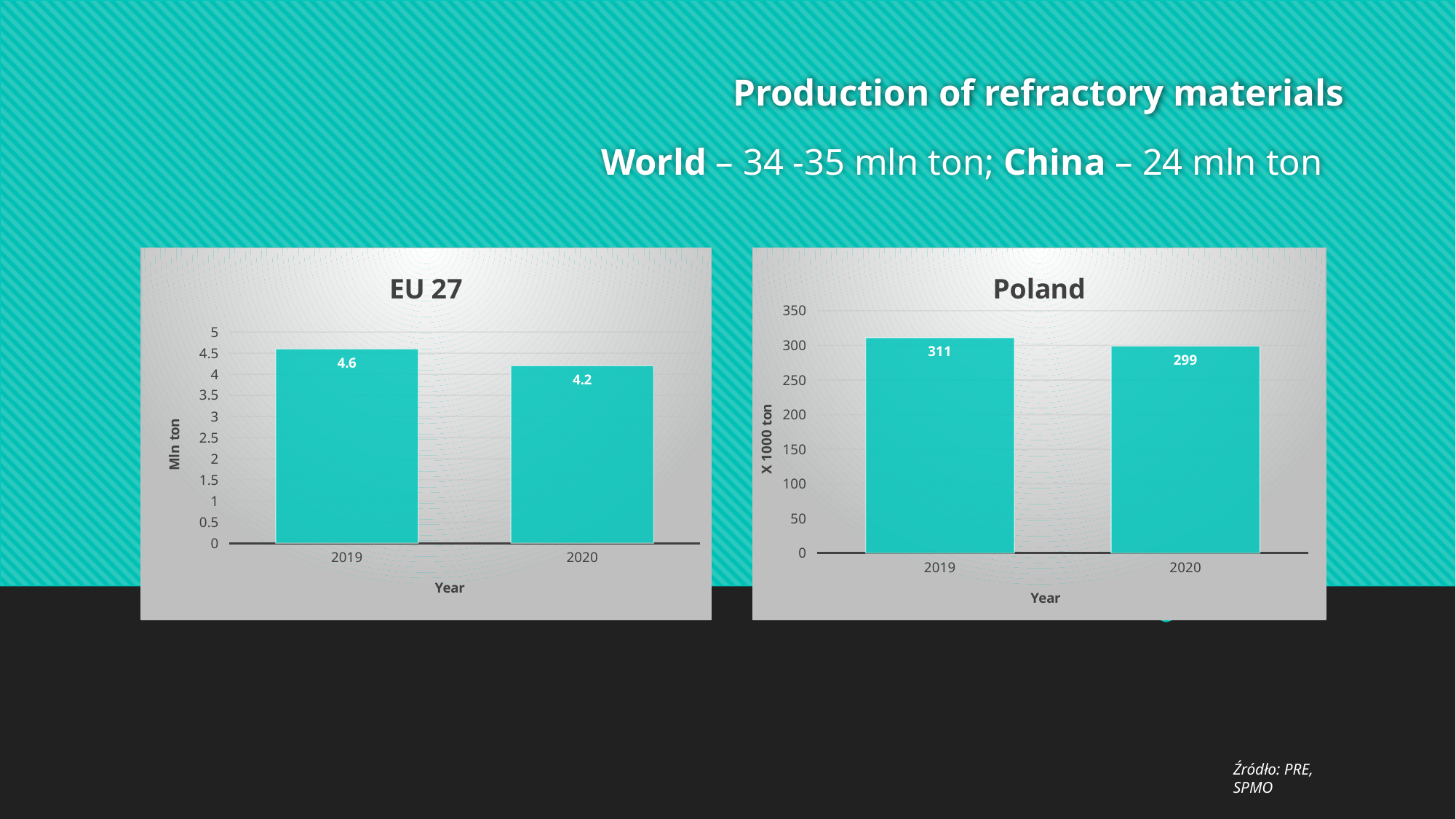
What kind of chart is the Poland chart? bar chart In the Poland chart, what is the value for 2019? 311 In the EU 27 chart, what is the value for 2020? 4.2 In the EU 27 chart, what is the difference between the 2019 and 2020 values? 0.4 In the Poland chart, which year has the lower value? 2020 In the EU 27 chart, do the values rise or fall from 2019 to 2020? fall In the EU 27 chart, what is the value for 2019? 4.6 What is the y-axis label of the Poland chart? X 1000 ton In the Poland chart, what is the value for 2020? 299 In the Poland chart, what is the difference between the 2019 and 2020 values? 12 In the EU 27 chart, which year has the higher value? 2019 In the Poland chart, is the value for 2020 greater or less than 300? less